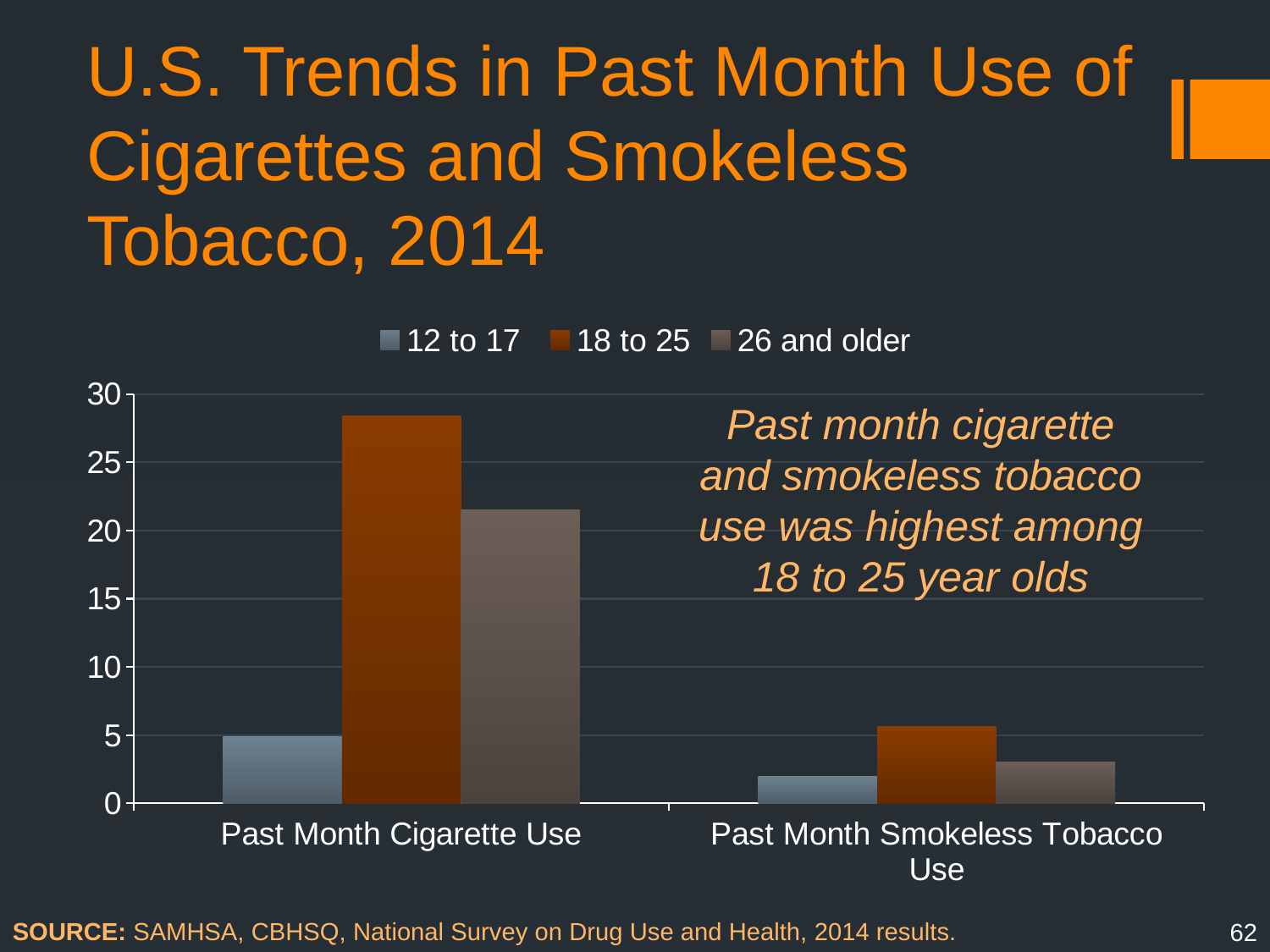
Is the value for 26 and older in Past Month Smokeless Tobacco Use greater or less than 5? less How many series does the legend list? 3 How many categories are shown on the x axis? 2 What is the title of the slide containing the chart? U.S. Trends in Past Month Use of Cigarettes and Smokeless Tobacco, 2014 Which is larger: the 26 and older value for Past Month Cigarette Use or the 26 and older value for Past Month Smokeless Tobacco Use? Past Month Cigarette Use Is the value for 26 and older in Past Month Cigarette Use greater or less than 20? greater Which age group has the lowest value for Past Month Cigarette Use? 12 to 17 Is the value for 18 to 25 in Past Month Cigarette Use greater or less than 25? greater Which age group has the highest value for Past Month Cigarette Use? 18 to 25 Which age group has the lowest value for Past Month Smokeless Tobacco Use? 12 to 17 What kind of chart is shown on the slide? bar chart